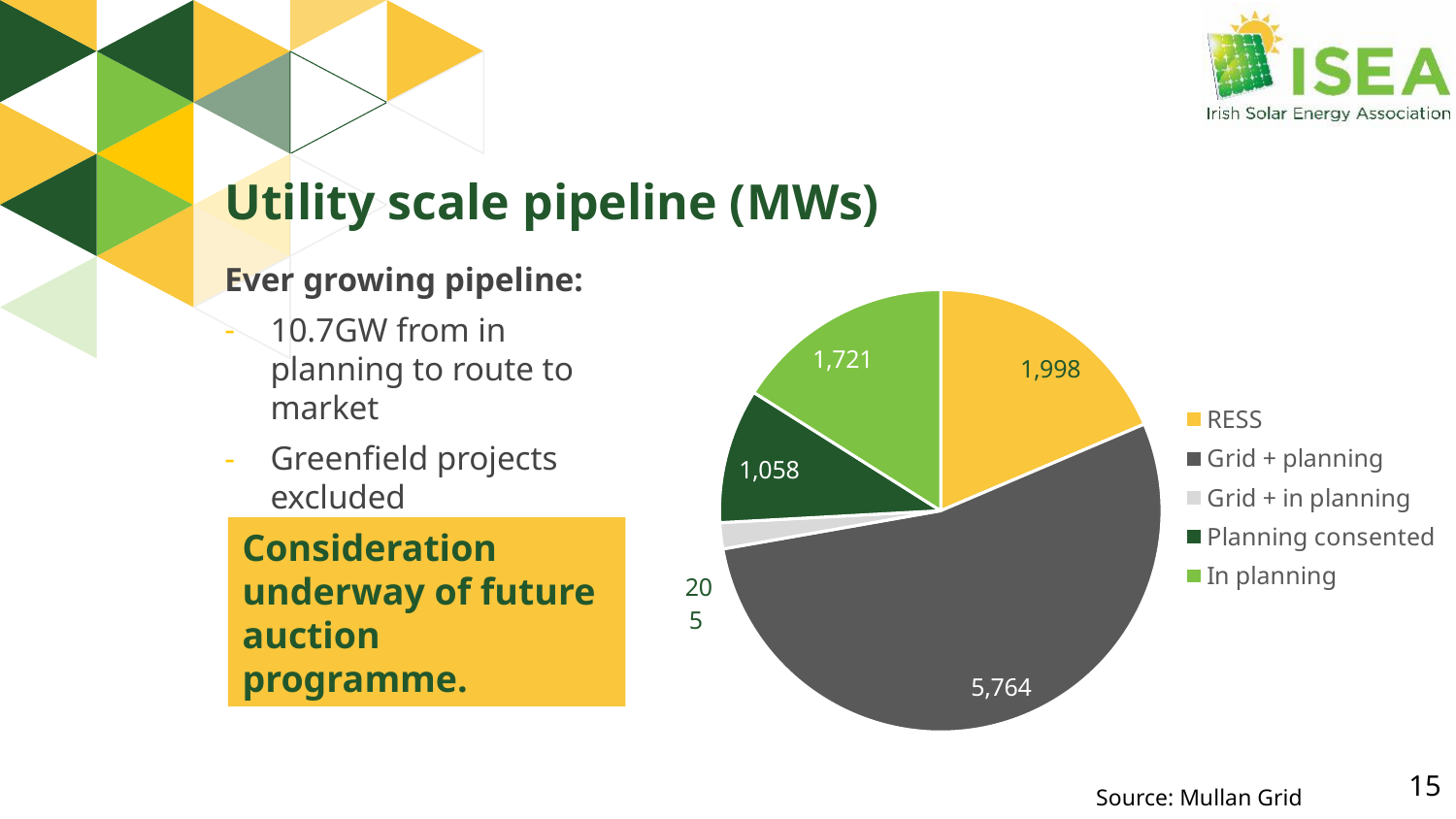
What is the value for RESS in the pie chart? 1,998 Which is larger, In planning or Planning consented? In planning How many slices does the pie chart have? 5 What is the difference between the RESS value and the In planning value? 277 What is the total of all the slices in the pie chart? 10,746 What is the value for In planning in the pie chart? 1,721 What kind of chart is shown on the slide? Pie chart What colour is the RESS slice in the pie chart? Yellow What is the value for Planning consented in the pie chart? 1,058 Which category has the smallest slice of the pie chart? Grid + in planning What is the value for Grid + planning in the pie chart? 5,764 Which category has the largest slice of the pie chart? Grid + planning